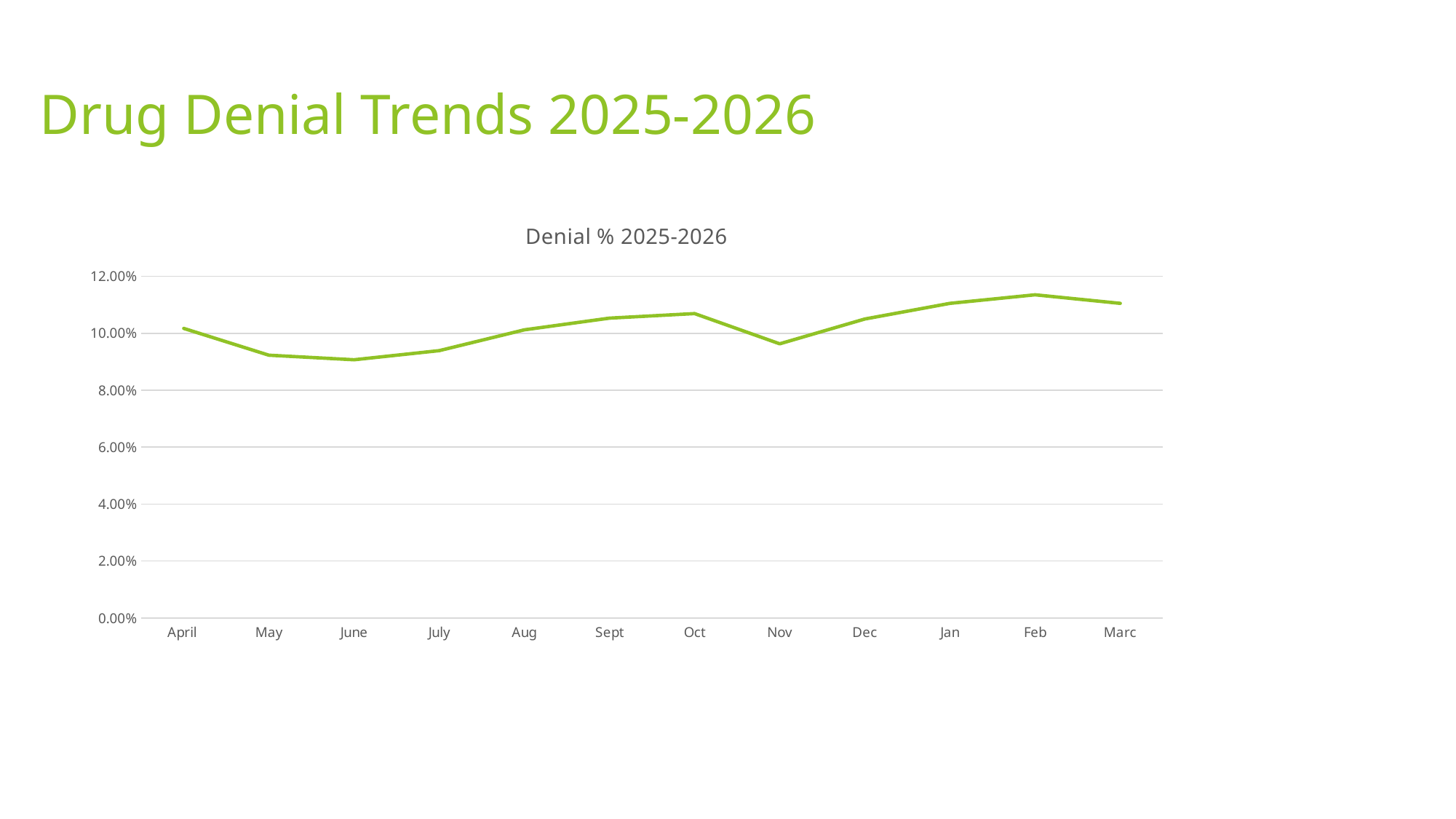
What is the title of the chart? Denial % 2025-2026 Which month has the larger denial percentage, June or Feb? Feb Is the value for Feb greater or less than 10.00%? greater Is the value for May greater or less than 10.00%? less Which month has the larger denial percentage, Oct or Nov? Oct What kind of chart is shown on the slide? line chart Does the denial percentage rise or fall from Nov to Feb? rise In which month does the denial percentage reach its highest point? Feb How many months are plotted along the x axis of the chart? 12 Is the value for April greater or less than 10.00%? greater Does the denial percentage rise or fall from April to June? fall